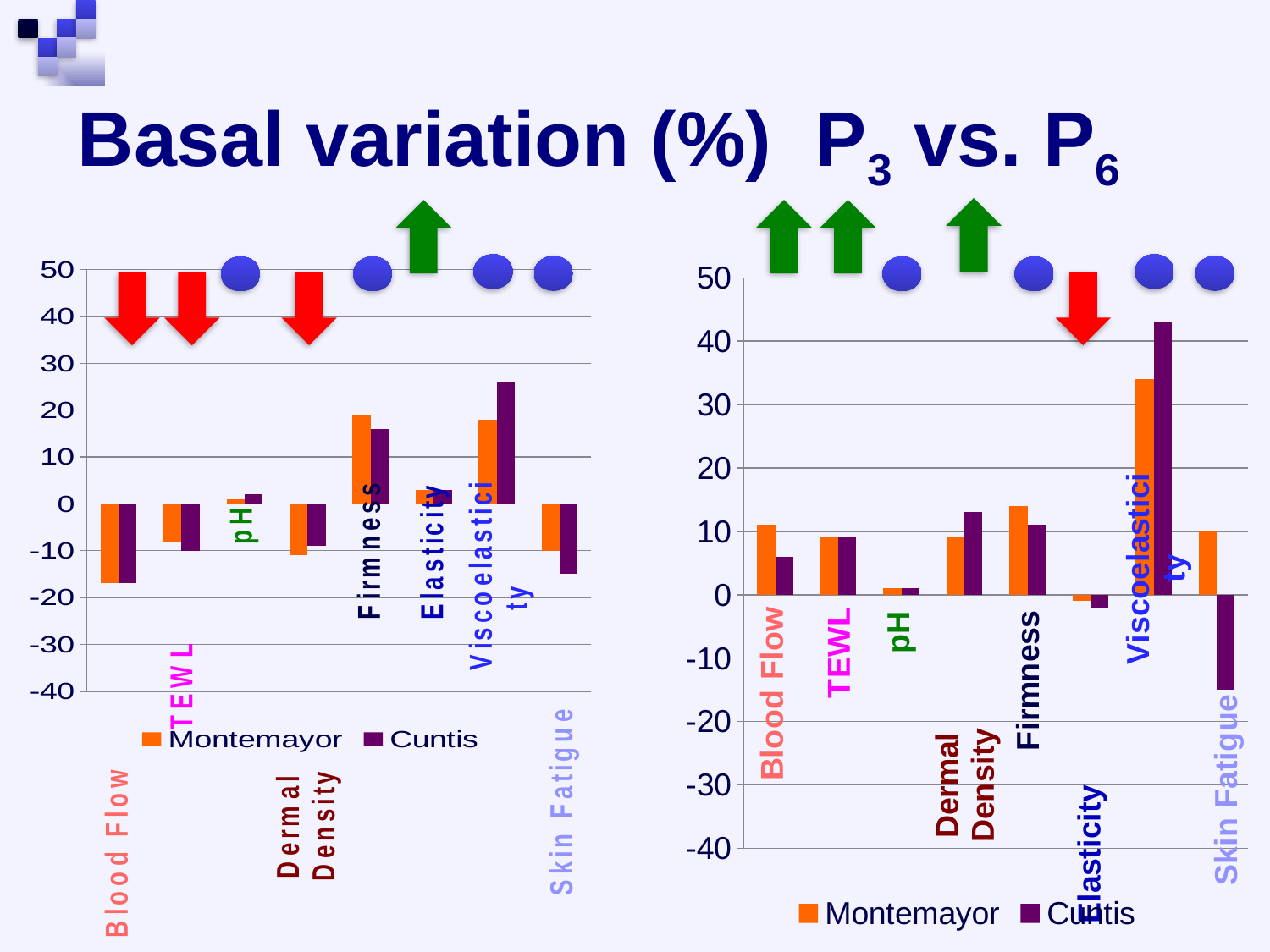
On the left chart, which category has the lowest Montemayor value? Blood Flow What is the title of the slide? Basal variation (%) P3 vs. P6 How many categories are plotted on the left chart? 8 On the right chart, is the Cuntis value for Skin Fatigue greater or less than -10? less On the left chart, is the Montemayor value for Blood Flow greater or less than -10? less On the right chart, is the Cuntis value for Viscoelasticity greater or less than 40? greater What kind of chart is the left chart on the slide? bar chart How many series does the legend of the right chart list? 2 On the right chart, which is larger for Skin Fatigue, the Montemayor value or the Cuntis value? Montemayor On the right chart, which category has the highest Cuntis value? Viscoelasticity On the left chart, which is larger for Viscoelasticity, the Montemayor value or the Cuntis value? Cuntis